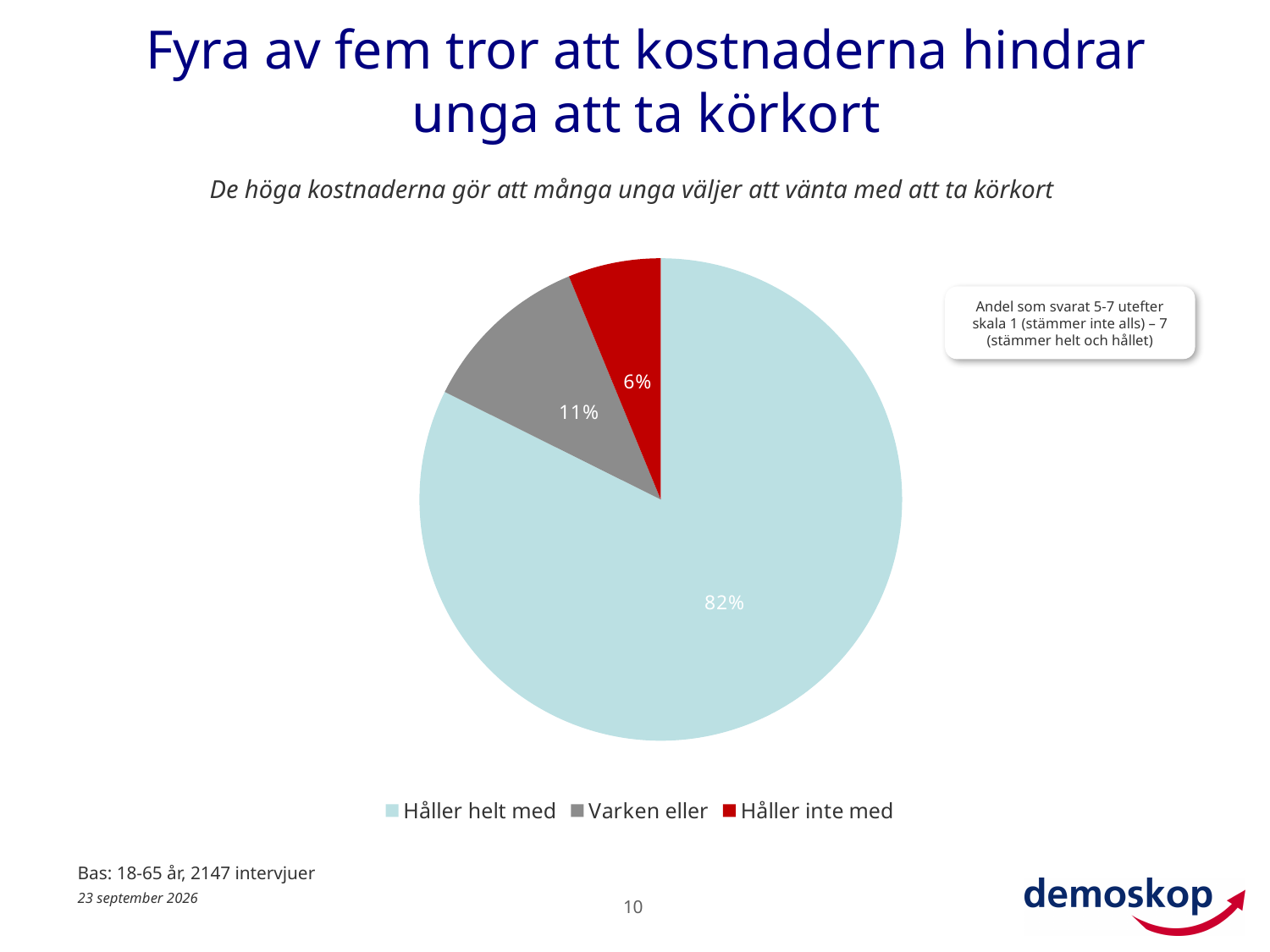
What is the difference in percentage points between "Varken eller" and "Håller inte med"? 5 How many entries does the legend list? 3 What kind of chart is shown on the slide? pie chart What share of respondents answered "Håller inte med"? 6% Which category has the largest slice of the pie? Håller helt med Which category has the smallest slice of the pie? Håller inte med What is the difference in percentage points between "Håller helt med" and "Varken eller"? 71 Which is larger, the share for "Varken eller" or the share for "Håller inte med"? Varken eller How many slices does the pie chart have? 3 What colour is the slice for "Håller inte med"? red What share of respondents answered "Varken eller"? 11% What share of respondents answered "Håller helt med"? 82%